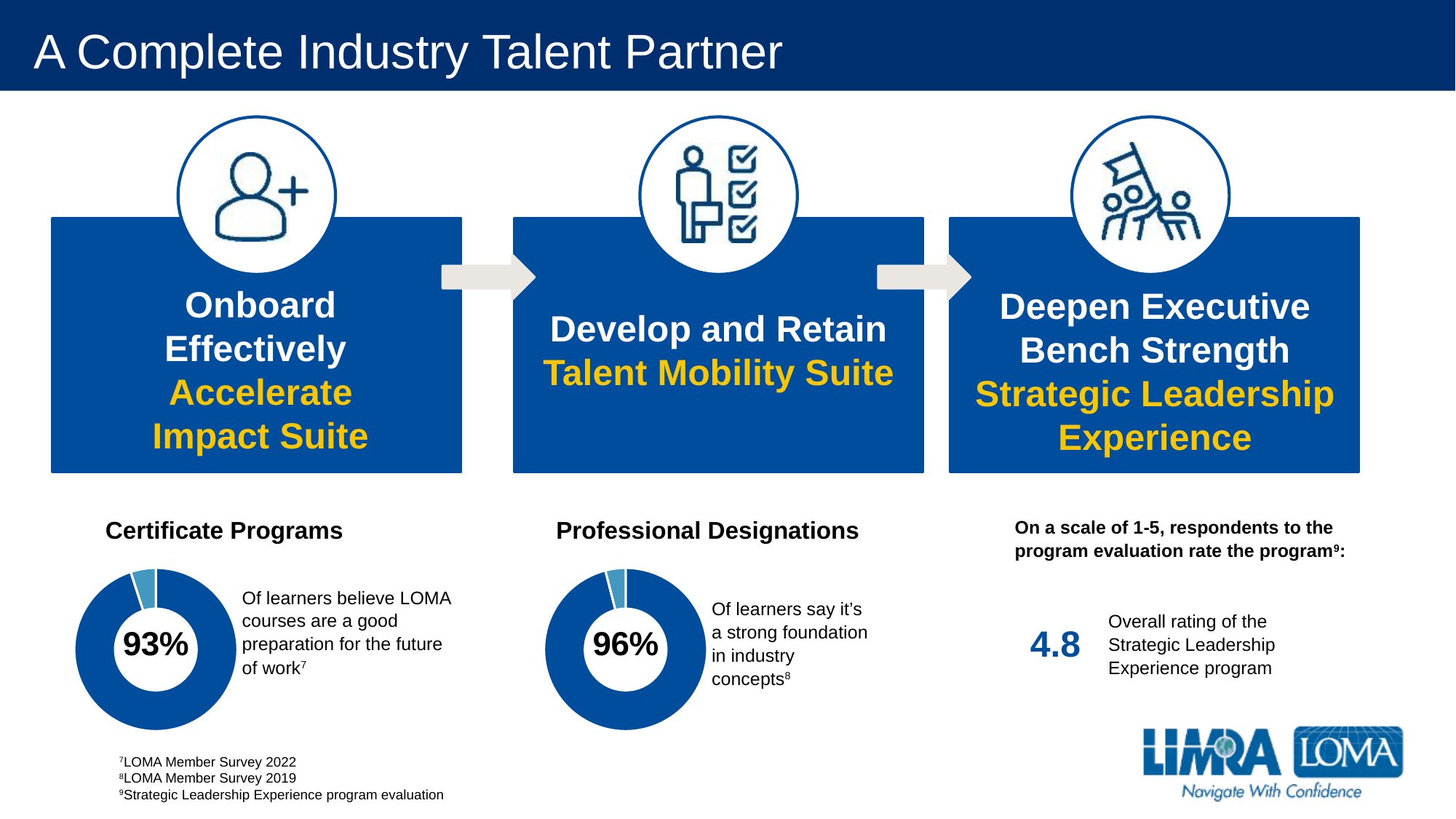
In the Certificate Programs chart, what percentage of learners believe LOMA courses are a good preparation for the future of work? 93% In the Professional Designations chart, what share of the donut does the large dark blue slice represent? 96% Which chart shows the larger percentage, Certificate Programs or Professional Designations? Professional Designations What kind of chart is used under the Certificate Programs heading? Donut (pie) chart In the Professional Designations chart, what percentage of learners say it's a strong foundation in industry concepts? 96% What kind of chart is used under the Professional Designations heading? Donut (pie) chart What is the difference between the percentage shown in the Professional Designations chart and the percentage shown in the Certificate Programs chart? 3 percentage points Is the value shown in the Certificate Programs chart greater or less than 90%? greater What is the title of the chart on the left of the slide? Certificate Programs What colour is the small slice in the Professional Designations donut chart? Light blue In the Certificate Programs chart, what share of the donut does the large dark blue slice represent? 93% How many slices does the Certificate Programs donut chart have? 2